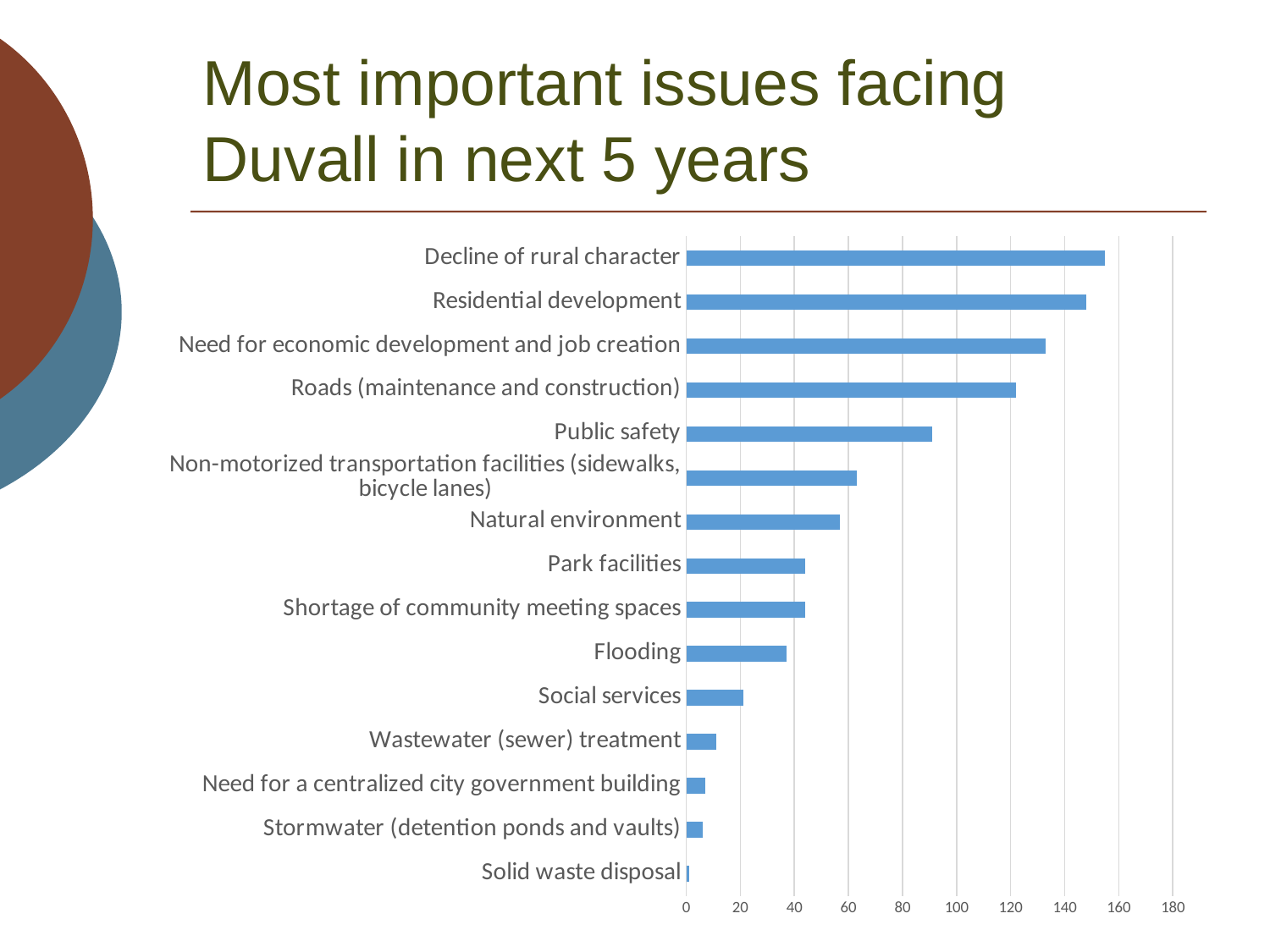
Which has a larger value, Residential development or Public safety? Residential development Is the value for Decline of rural character greater or less than 140? greater Which issue has the highest value in the chart? Decline of rural character What is the title of the slide containing the chart? Most important issues facing Duvall in next 5 years Which issue has the lowest value in the chart? Solid waste disposal Is the value for Public safety greater or less than 100? less Which has a larger value, Social services or Flooding? Flooding Is the value for Roads (maintenance and construction) greater or less than 100? greater What kind of chart is shown on the slide? bar chart How many issues (categories) are plotted in the chart? 15